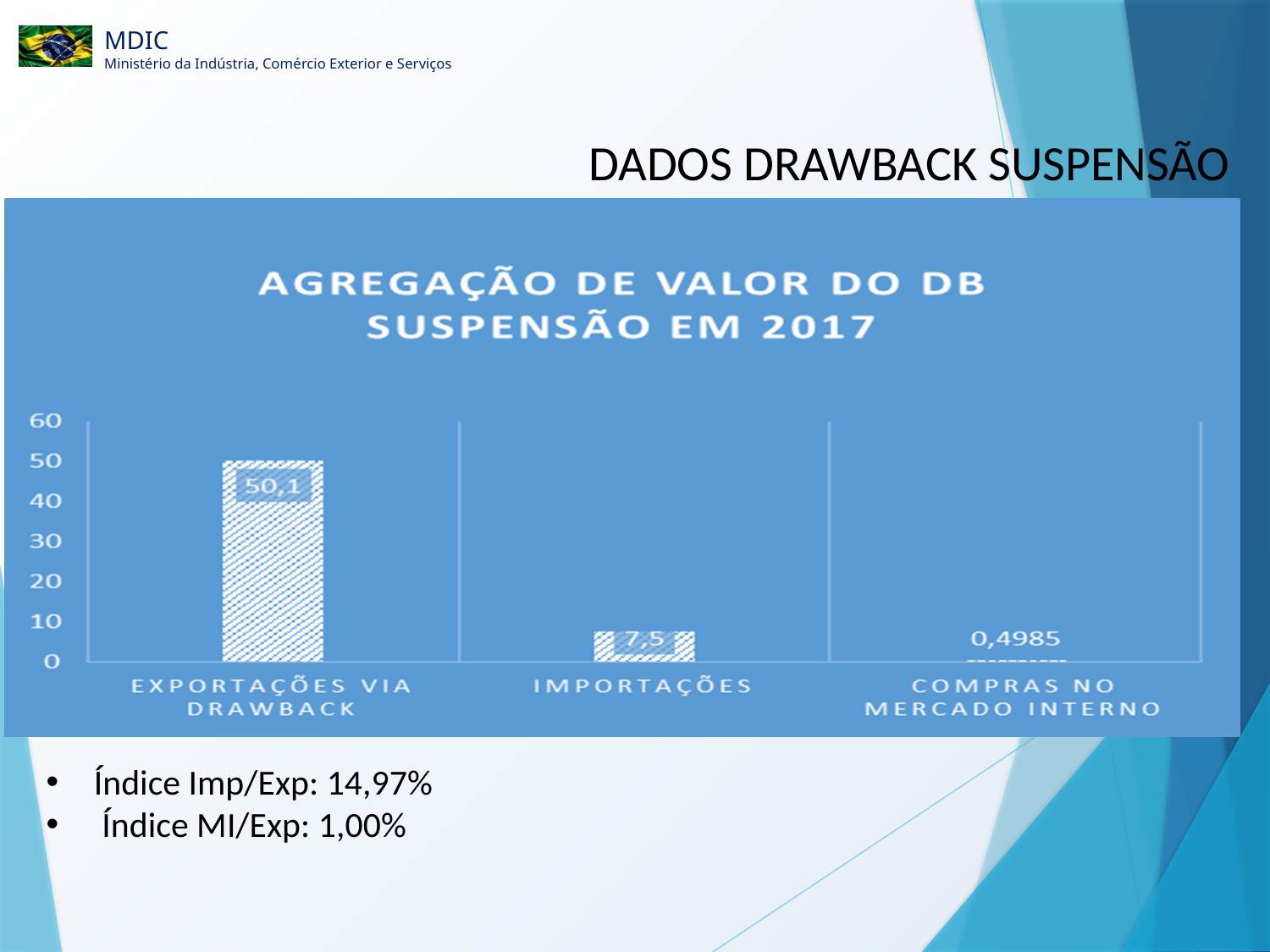
What is the title of the chart? AGREGAÇÃO DE VALOR DO DB SUSPENSÃO EM 2017 Which is larger, the value for Importações or the value for Compras no Mercado Interno? Importações Is the value for Importações greater or less than 10? less Which category has the lowest value? Compras no Mercado Interno What is the difference between the values for Exportações via Drawback and Importações? 42,6 Which category has the highest value? Exportações via Drawback What is the value for Exportações via Drawback? 50,1 What is the value for Compras no Mercado Interno? 0,4985 What is the value for Importações? 7,5 What kind of chart is shown? bar chart Is the value for Exportações via Drawback greater or less than 40? greater How many categories are shown on the x axis? 3